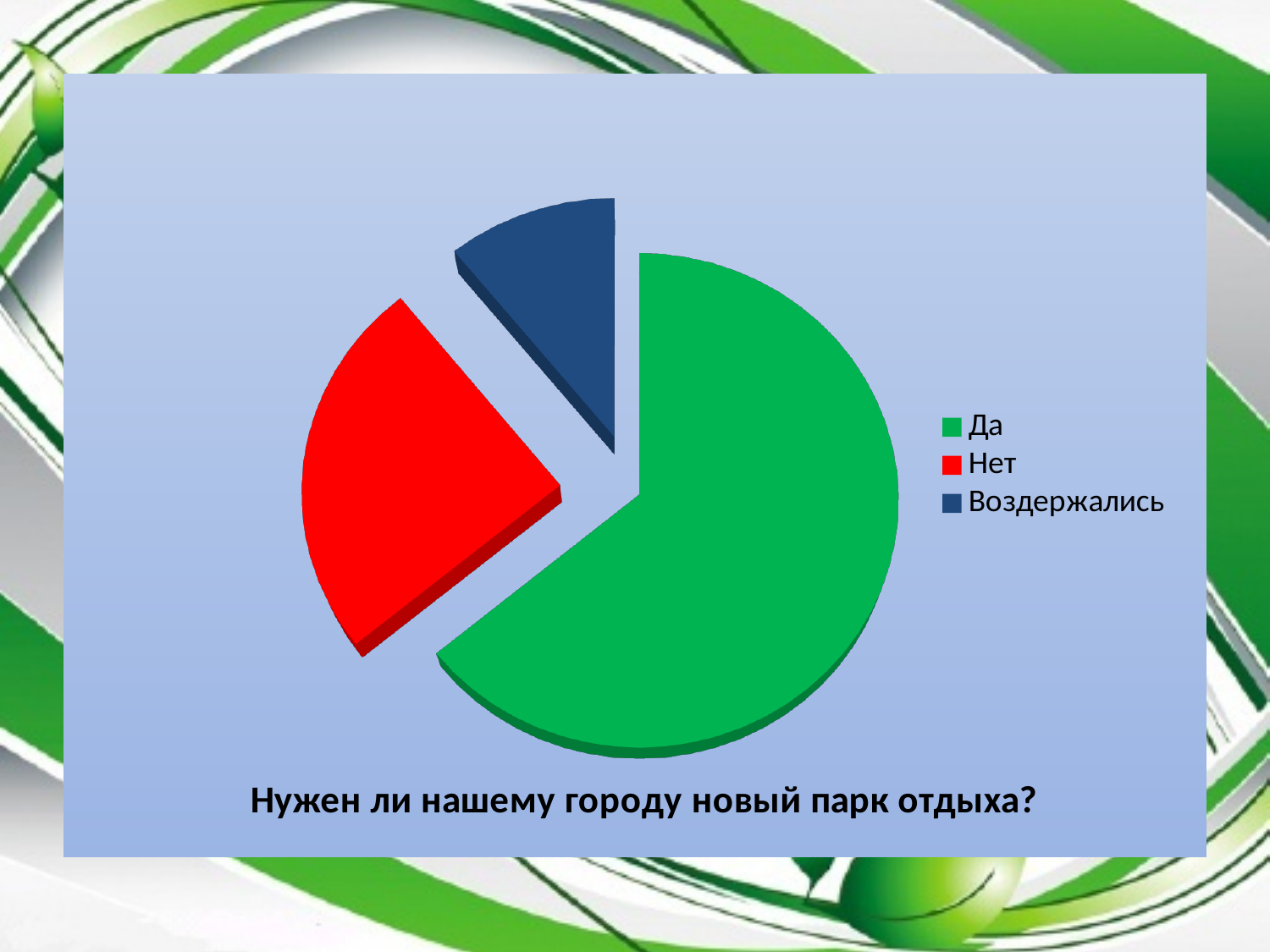
Which slice is larger, Да or Нет? Да Which category has the largest slice of the pie? Да How many entries does the legend list? 3 What kind of chart is shown on the slide? pie chart Which category has the smallest slice of the pie? Воздержались What is the title of the chart? Нужен ли нашему городу новый парк отдыха? Which slice is larger, Нет or Воздержались? Нет How many slices does the pie chart have? 3 What colour is the slice for Нет? red